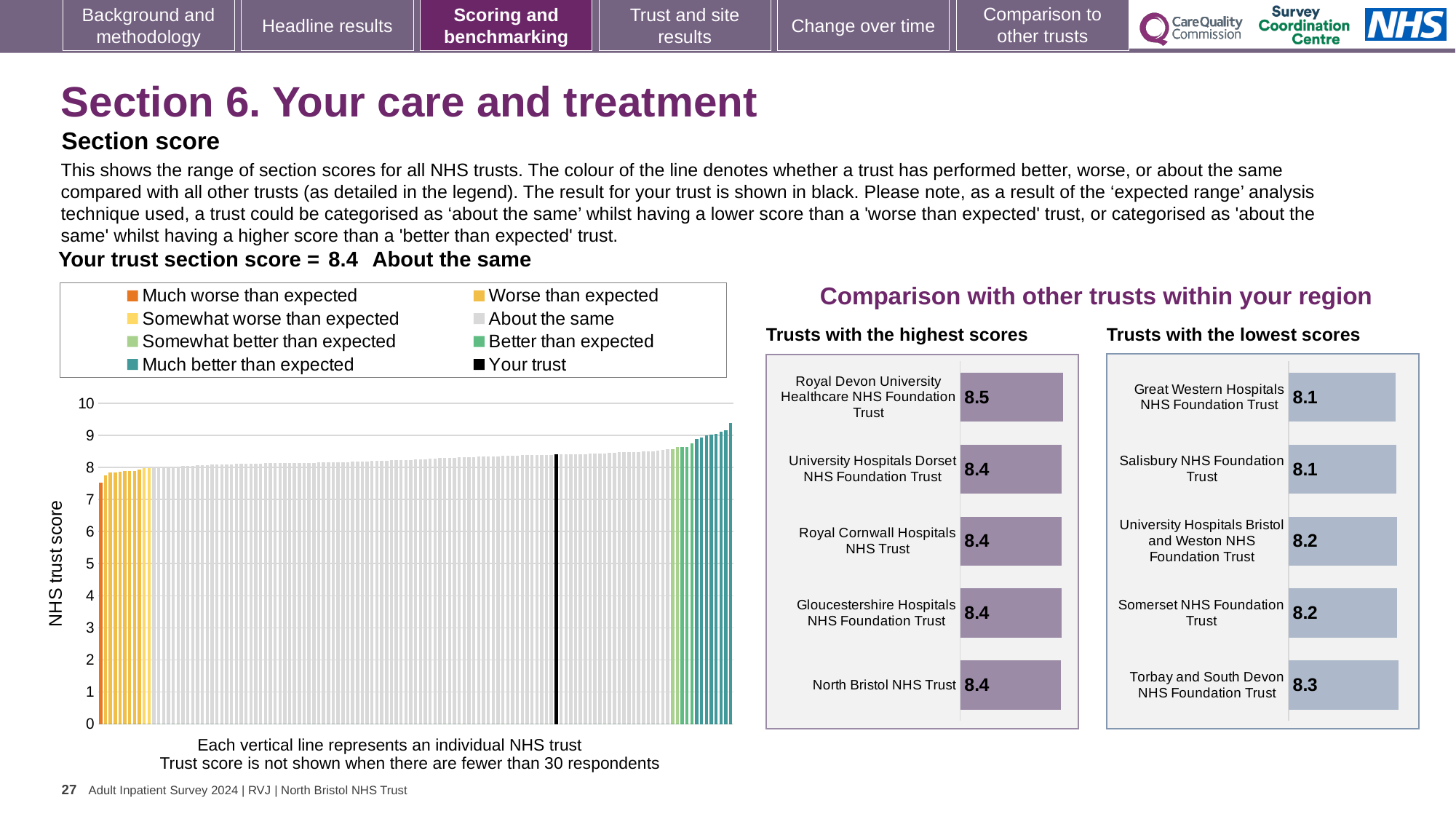
In the 'Trusts with the lowest scores' chart, what is the difference between the scores of Torbay and South Devon NHS Foundation Trust and Great Western Hospitals NHS Foundation Trust? 0.2 In the 'Trusts with the lowest scores' chart, which has the larger score: Somerset NHS Foundation Trust or Salisbury NHS Foundation Trust? Somerset NHS Foundation Trust In the main chart of NHS trust scores on the left, do the bar values rise or fall from left to right along the x axis? Rise In the 'Trusts with the lowest scores' chart, what is the score for Torbay and South Devon NHS Foundation Trust? 8.3 How many entries does the legend of the main chart of NHS trust scores on the left list? 8 In the main chart of NHS trust scores on the left, is the value for 'Your trust' greater or less than 8? greater What kind of chart is the 'Trusts with the lowest scores' chart? Bar chart How many trusts are shown in the 'Trusts with the highest scores' chart? 5 In the 'Trusts with the lowest scores' chart, which trust has the highest score? Torbay and South Devon NHS Foundation Trust In the 'Trusts with the highest scores' chart, what is the difference between the scores of Royal Devon University Healthcare NHS Foundation Trust and North Bristol NHS Trust? 0.1 In the 'Trusts with the highest scores' chart, what is the score for Royal Devon University Healthcare NHS Foundation Trust? 8.5 In the 'Trusts with the highest scores' chart, which trust has the highest score? Royal Devon University Healthcare NHS Foundation Trust